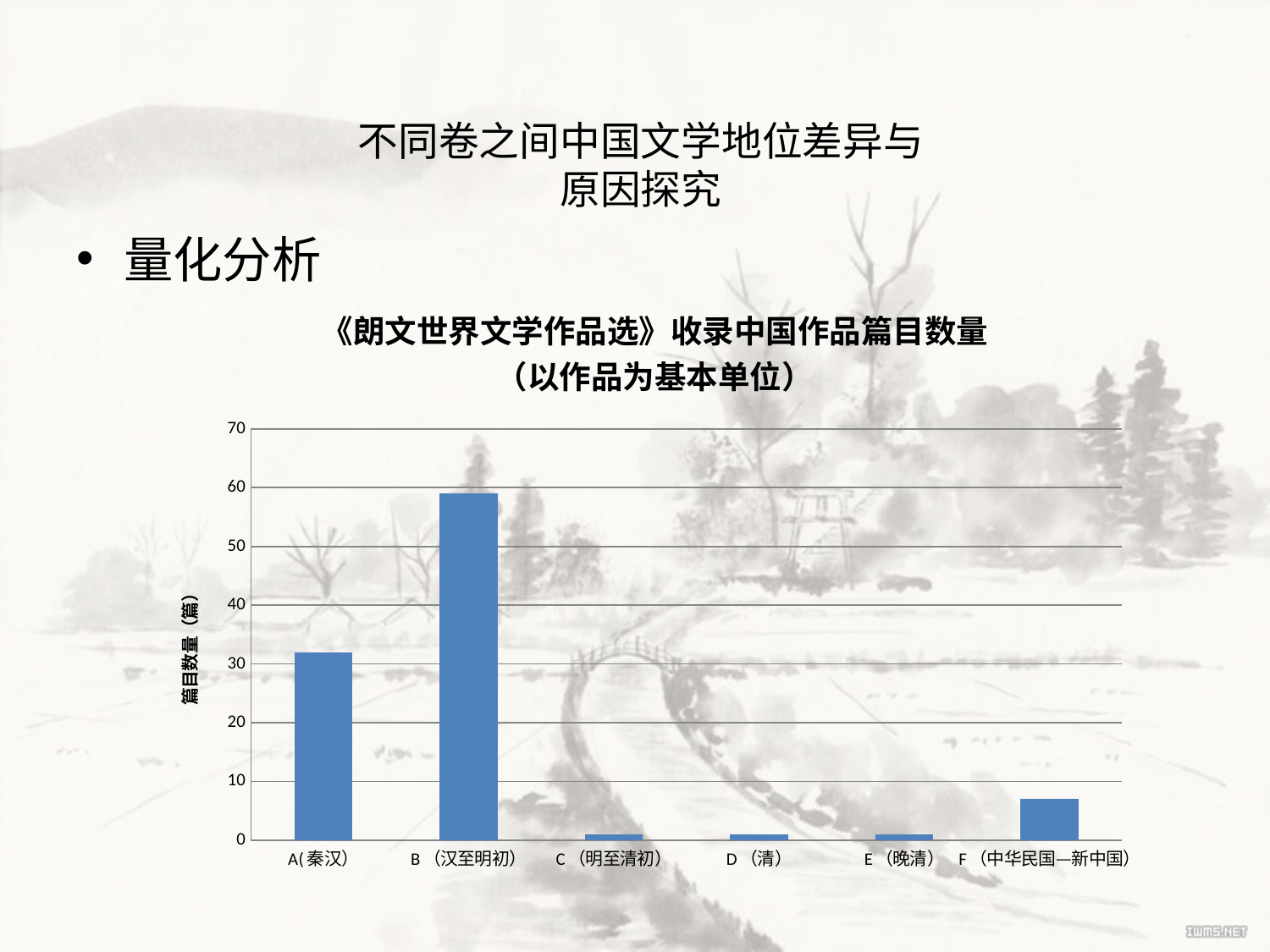
What is the title of the chart? 《朗文世界文学作品选》收录中国作品篇目数量（以作品为基本单位） Does the value rise or fall from A(秦汉) to B（汉至明初）? rise Is the value for A(秦汉) greater or less than 40? less Which is larger, the value for A(秦汉) or the value for B（汉至明初）? B（汉至明初） How many categories are shown on the x axis of the chart? 6 What is the label of the y axis of the chart? 篇目数量（篇） What kind of chart is shown on the slide? bar chart Is the value for B（汉至明初） greater or less than 50? greater Which is larger, the value for A(秦汉) or the value for F（中华民国—新中国）? A(秦汉) Is the value for F（中华民国—新中国） greater or less than 10? less Which category has the highest value in the chart? B（汉至明初）